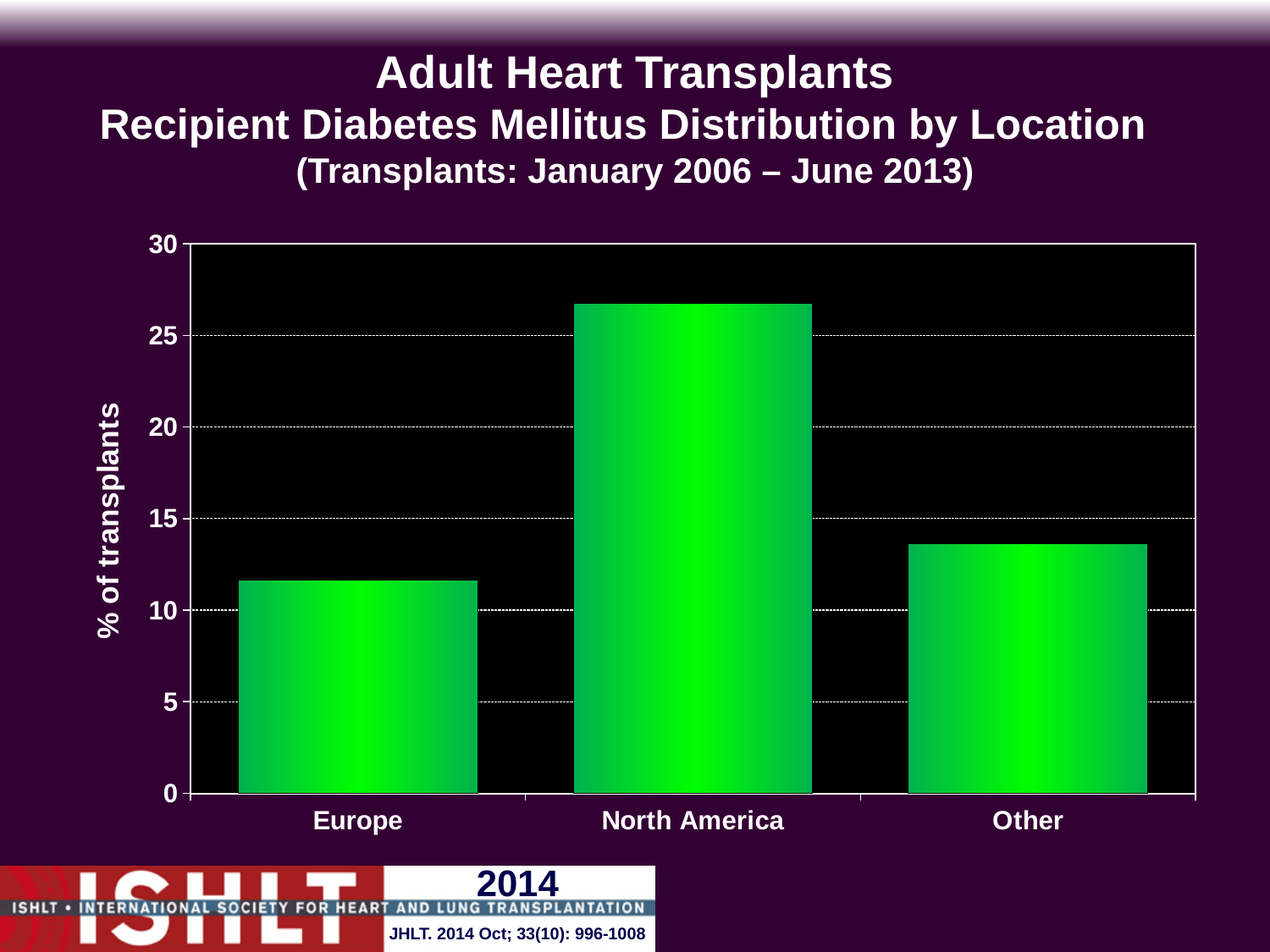
Which is larger, the value for Europe or the value for Other? Other How many location categories are shown on the x axis? 3 Is the value for Other greater or less than 10? greater Which is larger, the value for North America or the value for Other? North America Which location has the highest percentage of transplants with recipient diabetes mellitus? North America Which location has the lowest percentage of transplants with recipient diabetes mellitus? Europe What time period of transplants does the chart cover? January 2006 – June 2013 What is the label of the y axis? % of transplants Is the value for North America greater or less than 25? greater What type of chart is shown on the slide? bar chart Is the value for Europe greater or less than 15? less